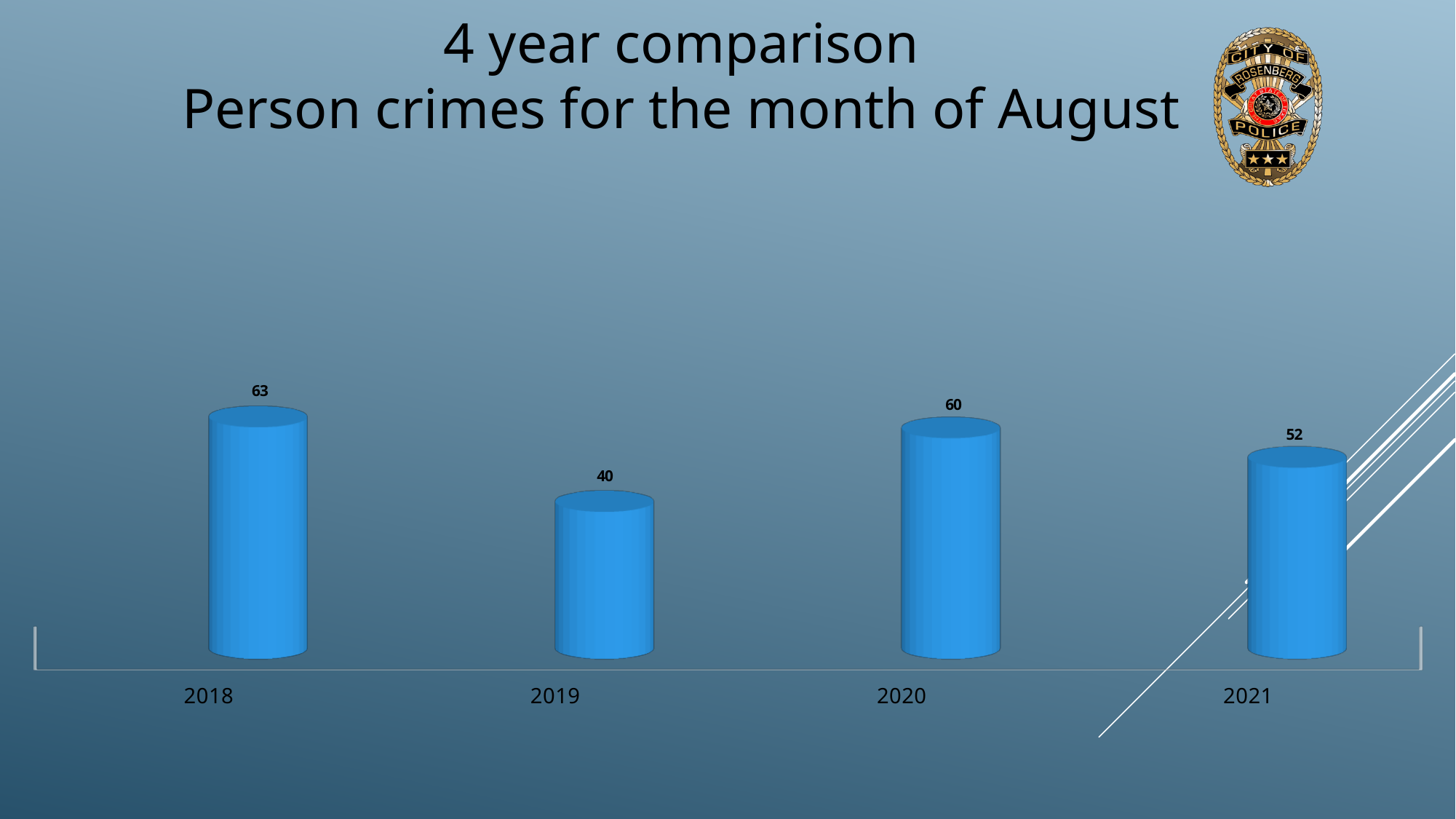
What is the value for 2021? 52 What is the value for 2020? 60 What is the difference between the values for 2020 and 2021? 8 What kind of chart is shown on the slide? Bar chart What is the value for 2018? 63 How many years are shown on the chart? 4 What is the difference between the values for 2018 and 2019? 23 What is the value for 2019? 40 What is the title of the slide? 4 year comparison Person crimes for the month of August Which year has the lowest value? 2019 Which is larger, the value for 2019 or the value for 2021? 2021 Which year has the highest value? 2018